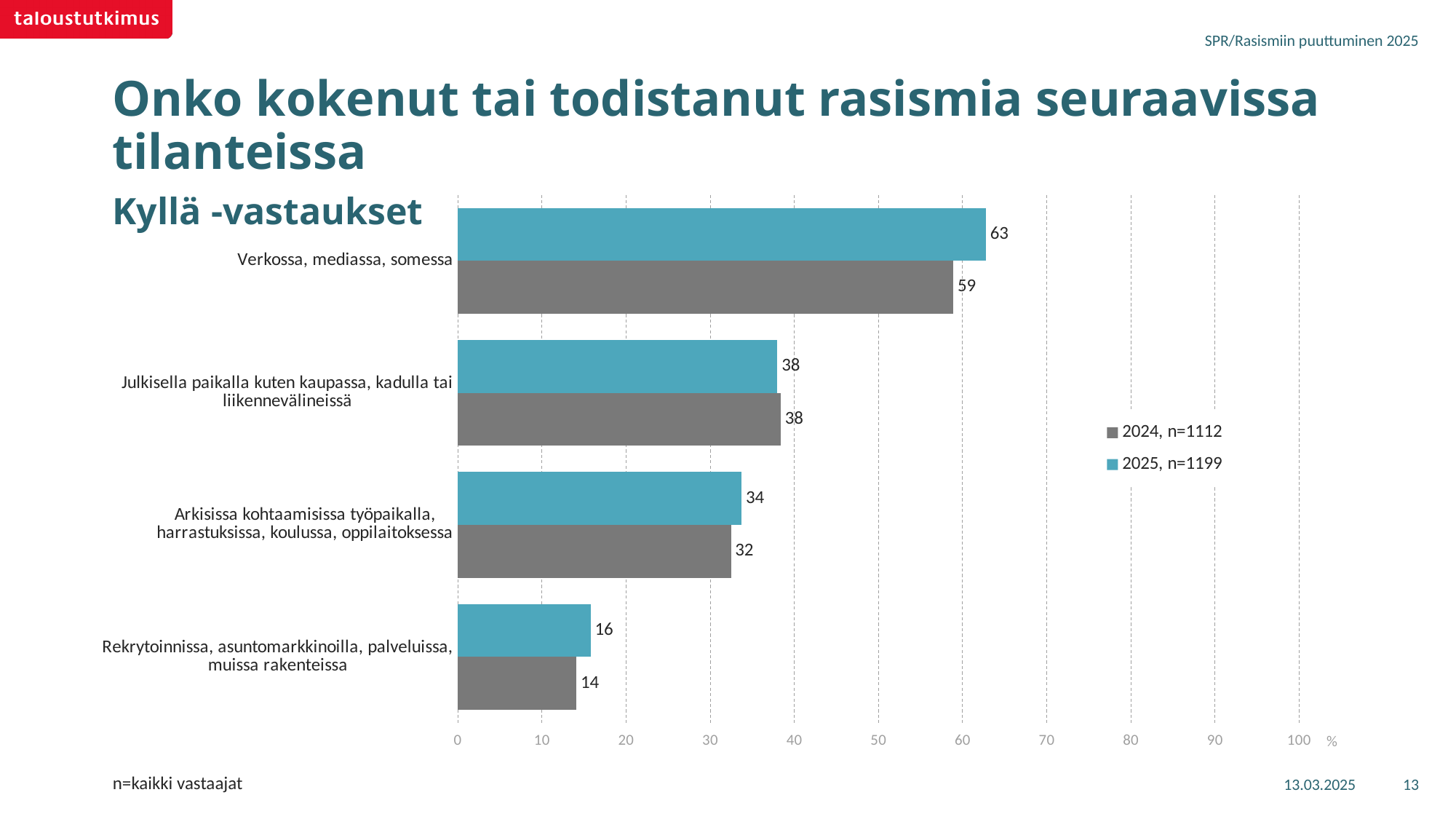
How many series does the legend list? 2 Is the 2024 value for "Verkossa, mediassa, somessa" greater or less than 50? greater What is the 2025 value for "Verkossa, mediassa, somessa"? 63 What kind of chart is shown on the slide? bar chart Which is larger for "Arkisissa kohtaamisissa työpaikalla, harrastuksissa, koulussa, oppilaitoksessa": the 2024 value or the 2025 value? 2025 Which category has the lowest 2024 value? Rekrytoinnissa, asuntomarkkinoilla, palveluissa, muissa rakenteissa What is the difference between the 2025 and 2024 values for "Verkossa, mediassa, somessa"? 4 What is the 2024 value for "Rekrytoinnissa, asuntomarkkinoilla, palveluissa, muissa rakenteissa"? 14 Which category has the highest 2025 value? Verkossa, mediassa, somessa What is the sample size (n) for the 2025 series according to the legend? 1199 What is the 2024 value for "Arkisissa kohtaamisissa työpaikalla, harrastuksissa, koulussa, oppilaitoksessa"? 32 How many categories are shown in the chart? 4